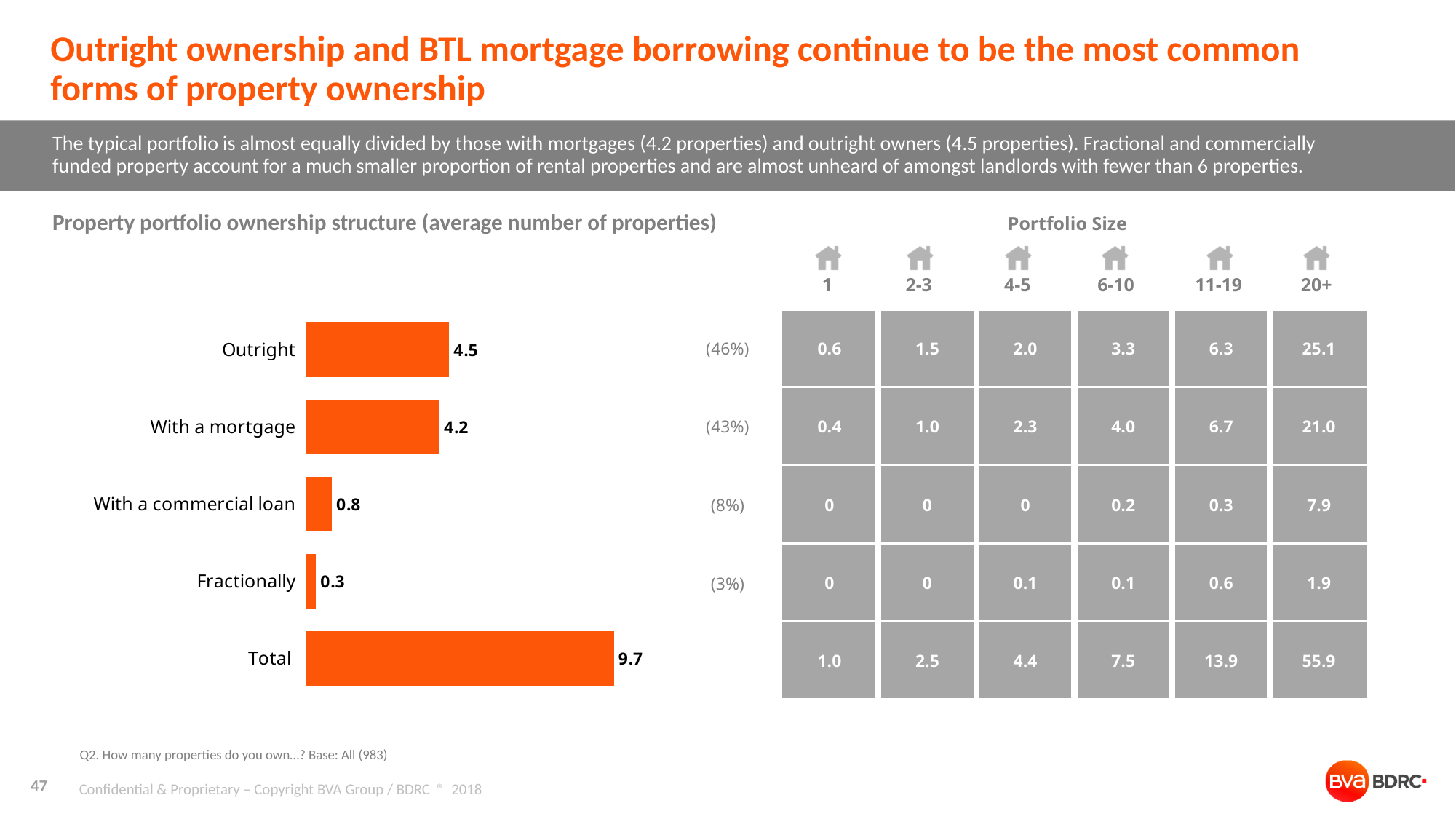
What is the value for Total in the bar chart? 9.7 What is the value for Fractionally in the bar chart? 0.3 How many bars are shown in the bar chart? 5 What is the difference between the values for Outright and With a mortgage in the bar chart? 0.3 What is the value for Outright in the bar chart? 4.5 Excluding the Total bar, which category has the highest value in the bar chart? Outright What is the title of the chart on the slide? Property portfolio ownership structure (average number of properties) What kind of chart is shown on the slide? Bar chart What is the value for With a mortgage in the bar chart? 4.2 Which is larger in the bar chart, With a commercial loan or Fractionally? With a commercial loan Which category has the lowest value in the bar chart? Fractionally What is the value for With a commercial loan in the bar chart? 0.8